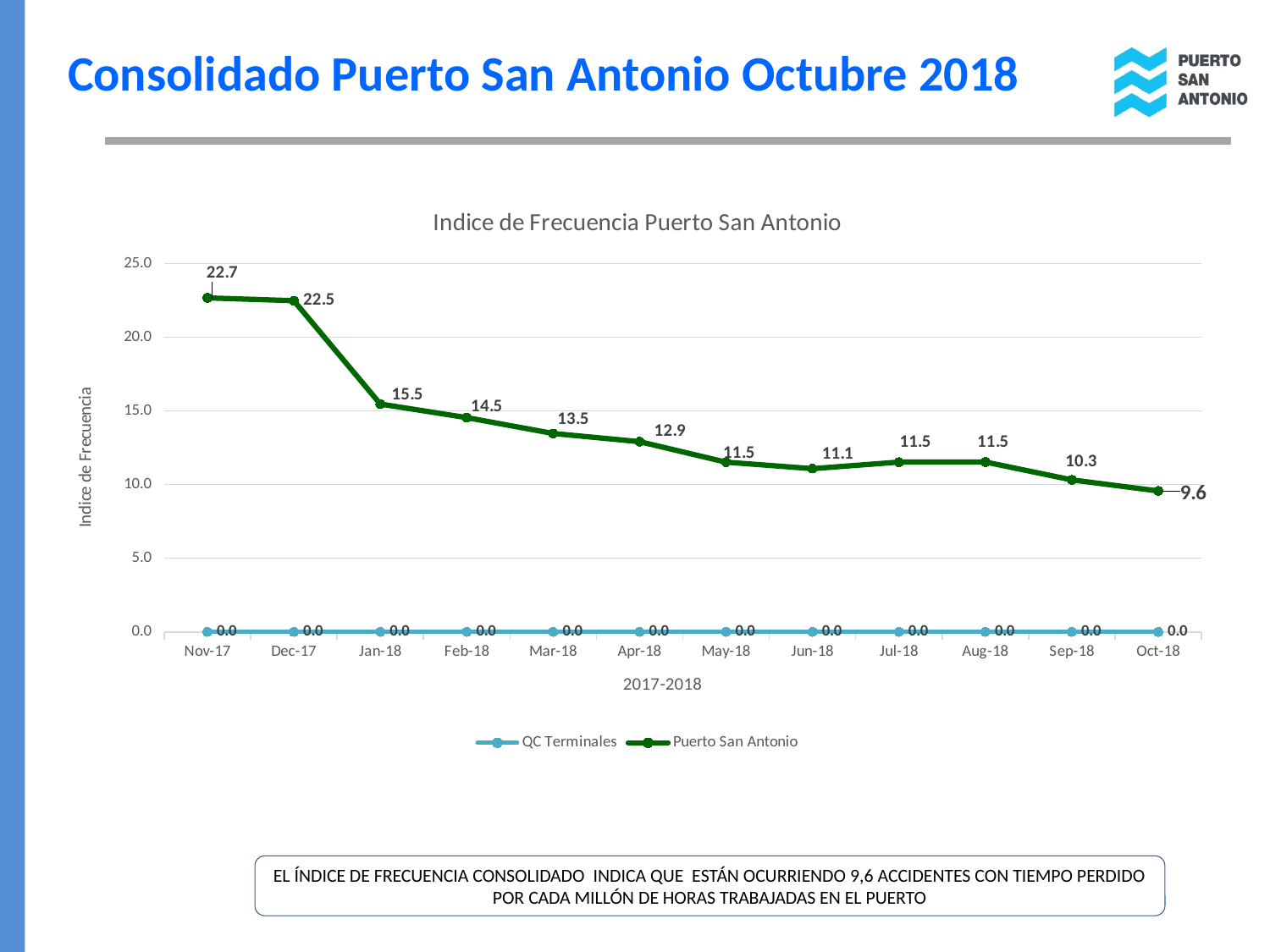
Which is larger for Puerto San Antonio, the value for Jan-18 or the value for Mar-18? Jan-18 What is the value for Puerto San Antonio in Oct-18? 9.6 How many months are shown on the x axis? 12 In which month is the Puerto San Antonio value highest? Nov-17 What is the value for Puerto San Antonio in Nov-17? 22.7 What is the difference between the Puerto San Antonio values for Nov-17 and Oct-18? 13.1 What is the value for QC Terminales in Jun-18? 0.0 What kind of chart is shown on the slide? Line chart Does the Puerto San Antonio series generally rise or fall from Nov-17 to Oct-18? Fall What is the value for Puerto San Antonio in Apr-18? 12.9 In which month is the Puerto San Antonio value lowest? Oct-18 How many series does the legend list? 2